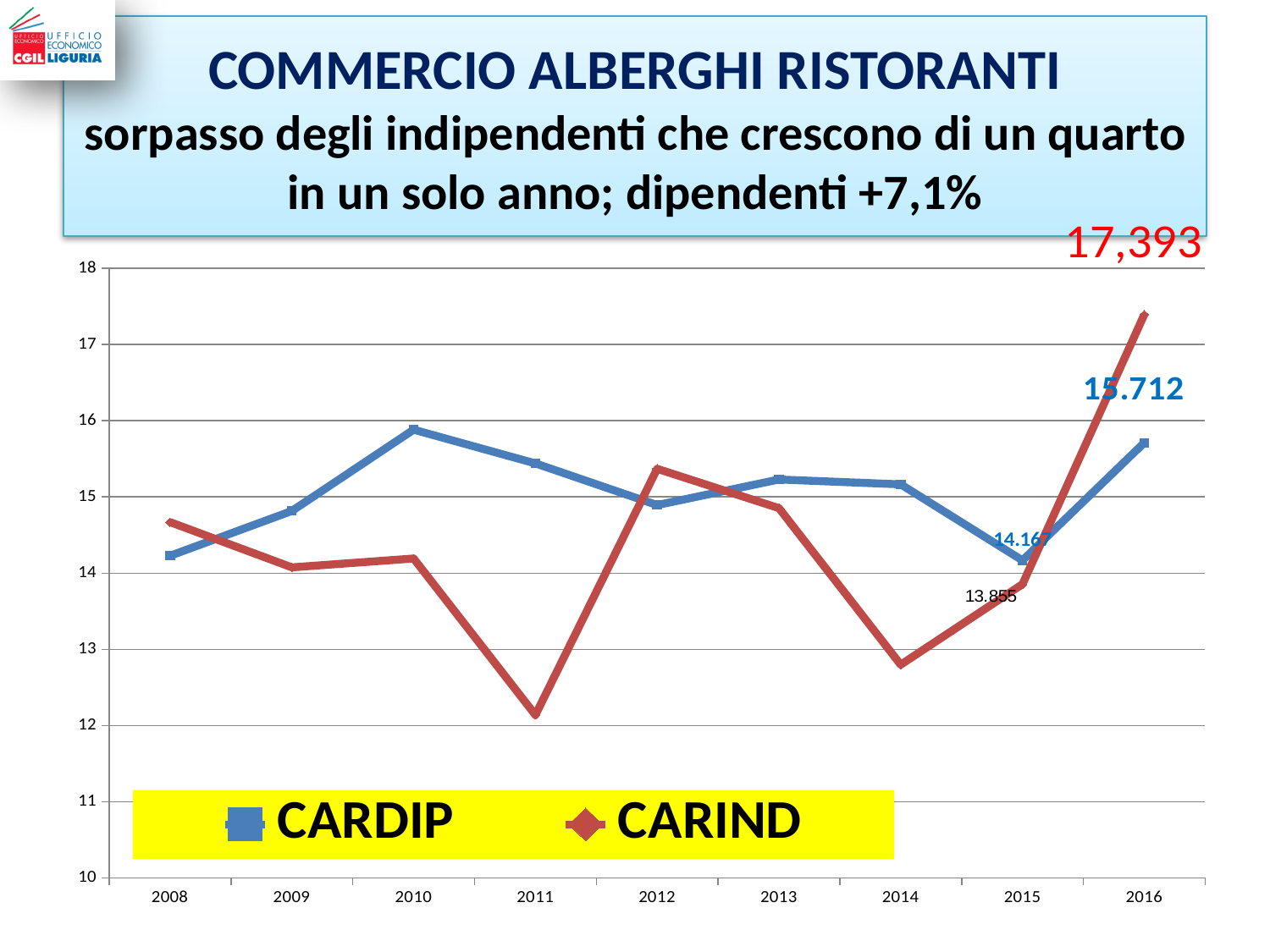
What is the value for CARDIP in 2016? 15.712 In 2016, which series has the larger value, CARDIP or CARIND? CARIND Which series is shown in red? CARIND In which year is the CARIND series at its lowest? 2011 Is the value for CARIND in 2011 greater or less than 13? less In which year is the CARDIP series at its highest? 2010 In which year is the CARIND series at its highest? 2016 What kind of chart is shown on the slide? line chart What is the value for CARIND in 2016? 17,393 How many years are plotted along the x axis? 9 How many series does the legend list? 2 What is the value for CARIND in 2015? 13.855